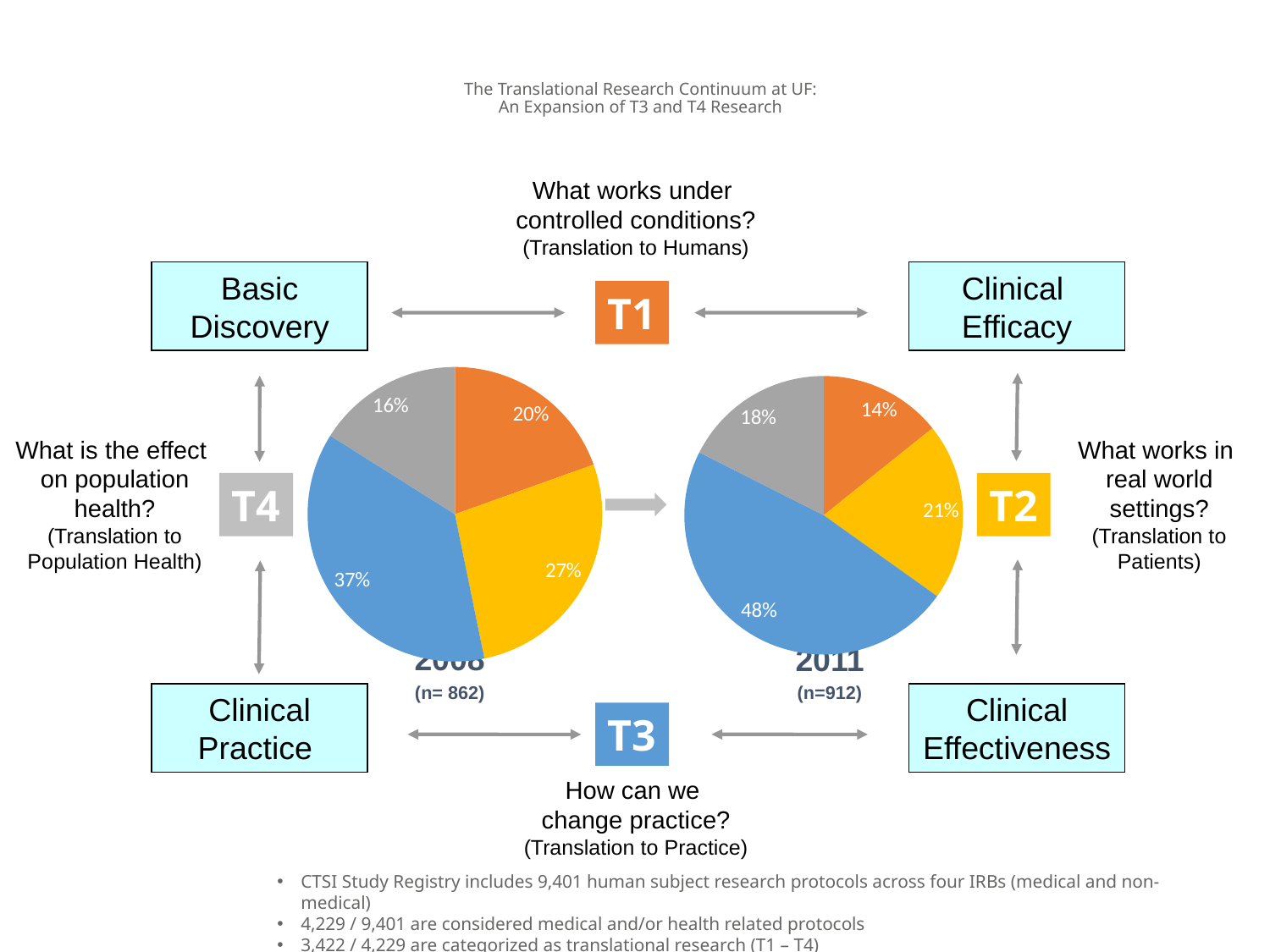
In the 2008 pie chart, which colour slice has the smallest share? Gray (16%) What kind of chart is used to show the 2008 and 2011 data on the slide? Pie chart Is the yellow slice larger in the 2008 pie chart or the 2011 pie chart? 2008 What sample size (n) is shown under the 2011 pie chart? n=912 In the 2011 pie chart, what percentage is shown for the blue slice? 48% How many slices does the 2011 pie chart have? 4 In the 2008 pie chart, what percentage is shown for the blue slice? 37% In the 2011 pie chart, which colour slice has the smallest share? Orange (14%) In the 2008 pie chart, what is the difference between the yellow slice and the orange slice? 7 percentage points Is the gray slice larger in the 2008 pie chart or the 2011 pie chart? 2011 By how many percentage points did the blue slice grow from the 2008 pie chart to the 2011 pie chart? 11 percentage points In the 2008 pie chart, which colour slice has the largest share? Blue (37%)